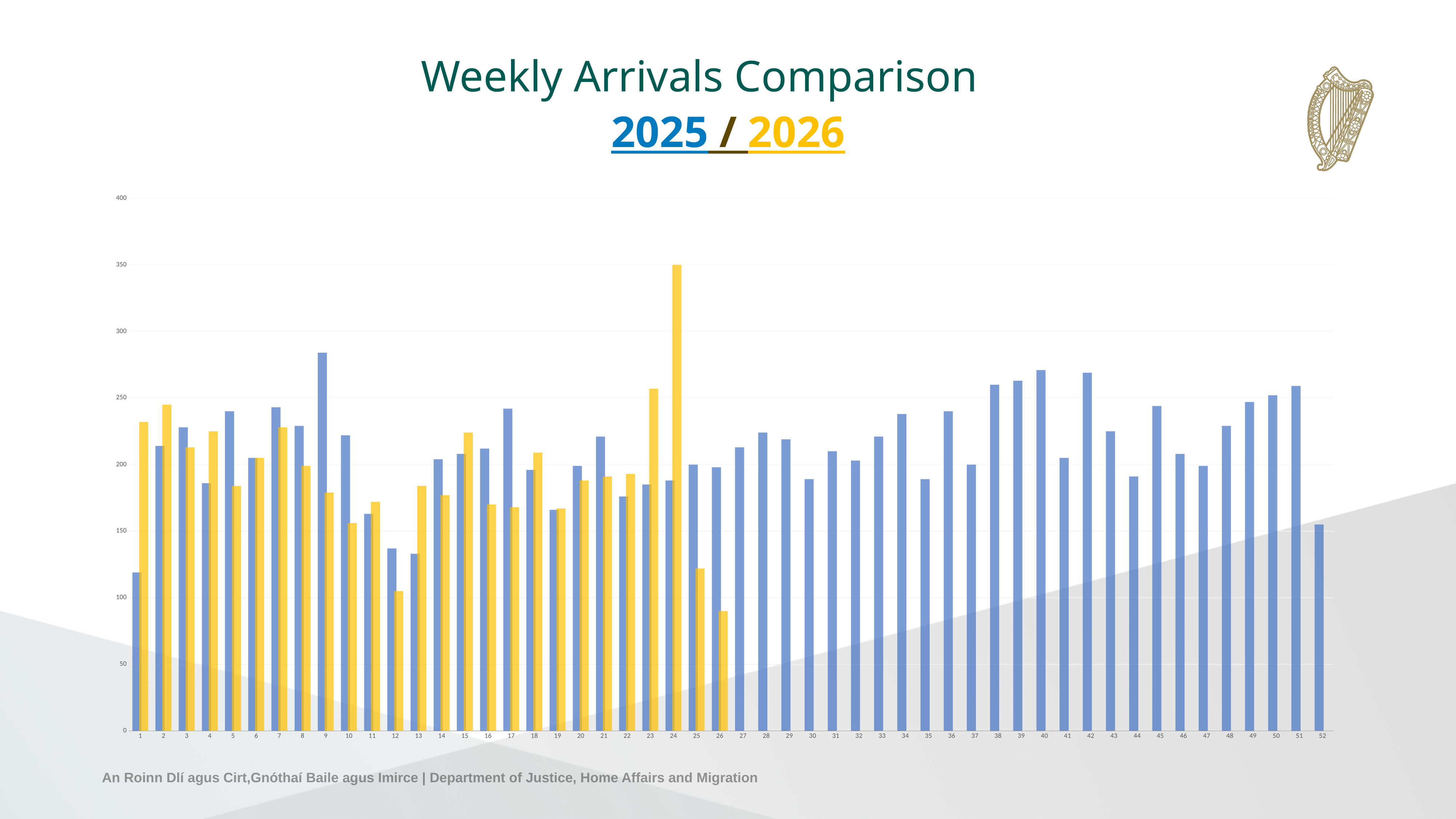
Is the 2026 value for week 24 greater or less than 300? greater How many series does the chart compare? 2 Which week has the lowest 2025 (blue) value? 1 Is the 2025 value for week 1 greater or less than 150? less Which week has the highest 2025 (blue) value? 9 Is the 2025 value for week 40 greater or less than 250? greater Which week has the highest 2026 (yellow) value? 24 What kind of chart is shown on the slide? bar chart How many weeks are shown along the x axis? 52 Which colour represents the 2026 series? yellow In week 25, which series has the larger value, 2025 or 2026? 2025